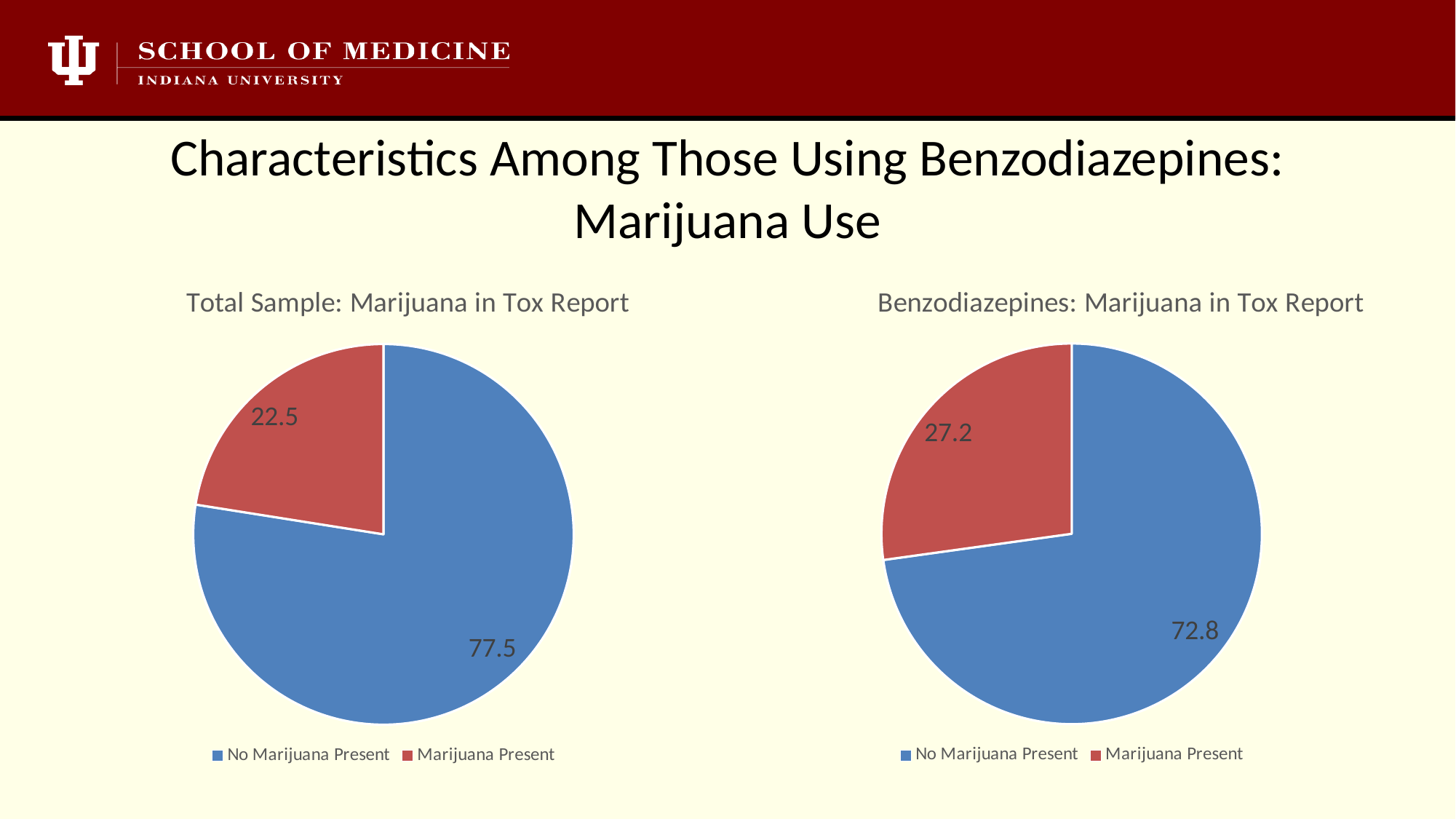
How many categories does the 'Benzodiazepines: Marijuana in Tox Report' chart show? 2 In the 'Total Sample: Marijuana in Tox Report' chart, what is the value for Marijuana Present? 22.5 In the 'Benzodiazepines: Marijuana in Tox Report' chart, which category has the smallest slice? Marijuana Present In the 'Benzodiazepines: Marijuana in Tox Report' chart, what is the value for No Marijuana Present? 72.8 In the 'Total Sample: Marijuana in Tox Report' chart, what is the value for No Marijuana Present? 77.5 Is the Marijuana Present value larger in the 'Total Sample: Marijuana in Tox Report' chart or the 'Benzodiazepines: Marijuana in Tox Report' chart? Benzodiazepines: Marijuana in Tox Report In the 'Benzodiazepines: Marijuana in Tox Report' chart, what is the difference between No Marijuana Present and Marijuana Present? 45.6 In the 'Total Sample: Marijuana in Tox Report' chart, what is the difference between No Marijuana Present and Marijuana Present? 55 In the 'Total Sample: Marijuana in Tox Report' chart, which category has the largest slice? No Marijuana Present What type of chart is the 'Total Sample: Marijuana in Tox Report' chart? Pie chart In the 'Benzodiazepines: Marijuana in Tox Report' chart, what is the value for Marijuana Present? 27.2 In the 'Total Sample: Marijuana in Tox Report' chart, what colour is the Marijuana Present slice? Red